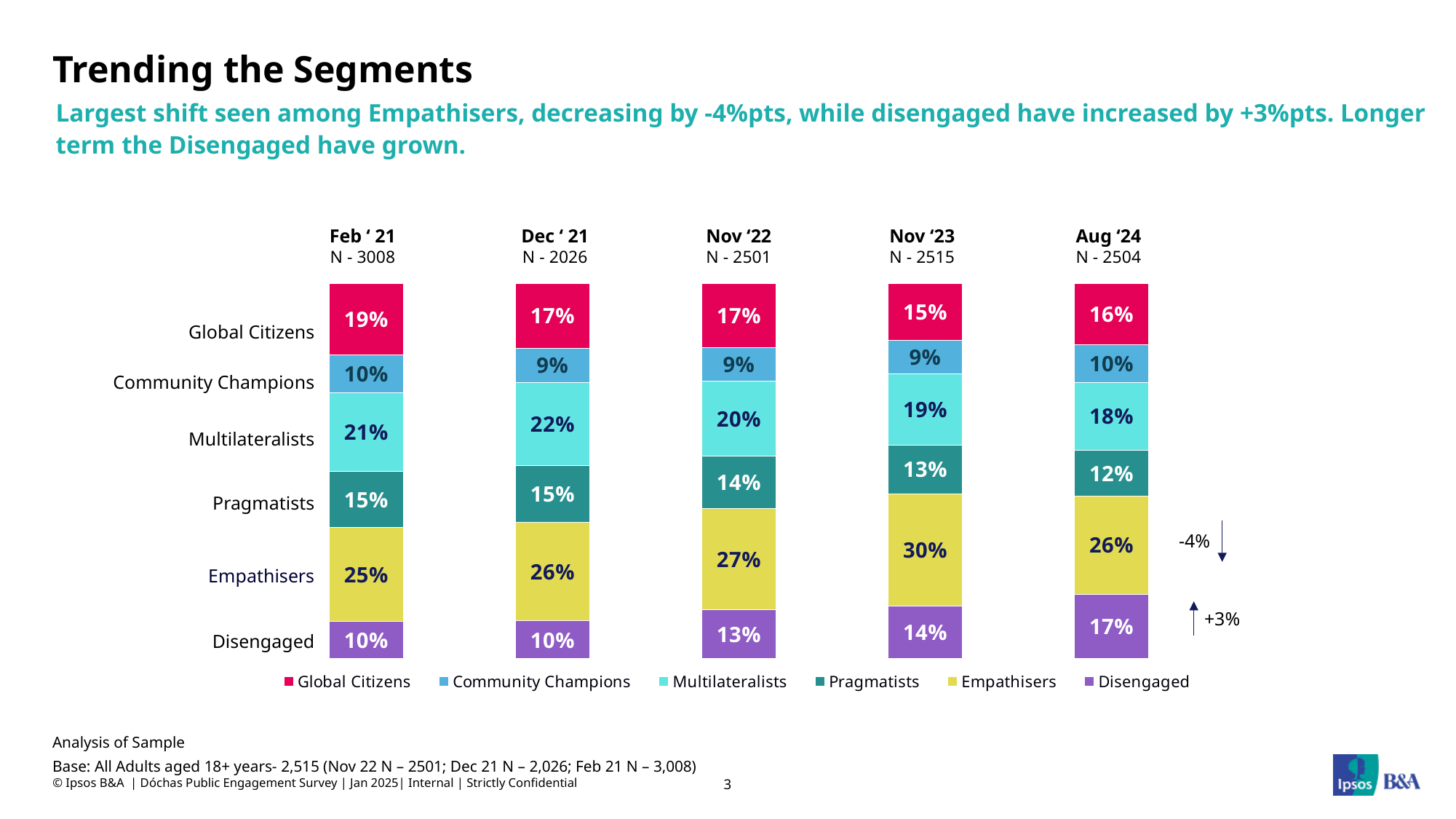
How many segments does the legend list? 6 What is the value for Global Citizens in Nov '23? 15% In which wave is the Global Citizens segment lowest? Nov '23 What percentage of the Aug '24 bar is Empathisers? 26% In which wave is the Empathisers segment highest? Nov '23 What is the difference between the Disengaged value in Aug '24 and in Nov '23? 3% What is the sample size (N) shown for the Feb '21 wave? 3008 Does the Disengaged segment rise or fall from Feb '21 to Aug '24? Rise How many time periods (bars) are shown in the chart? 5 What kind of chart is shown on the slide? Stacked bar chart Which is larger in Nov '22: Multilateralists or Pragmatists? Multilateralists What is the value for Disengaged in Feb '21? 10%